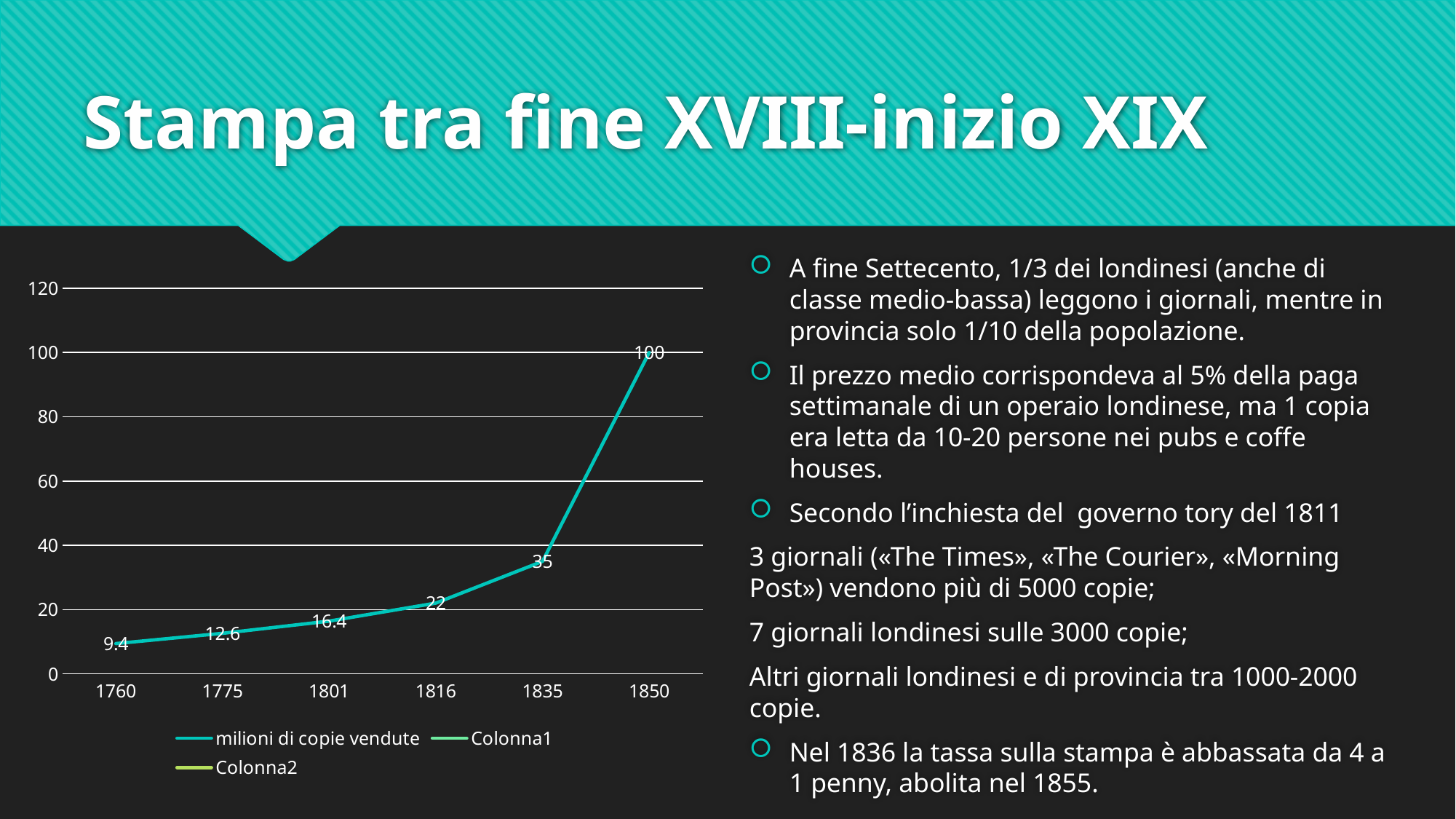
What is the value for 1801 in the chart? 16.4 Which is larger, the value for 1816 or the value for 1801? 1816 How many entries does the chart legend list? 3 Which year has the highest value in the chart? 1850 What is the value for 1850 in the chart? 100 What is the value for 1760 in the chart? 9.4 What is the difference between the values for 1850 and 1835? 65 What kind of chart is shown on the slide? line chart How many years are plotted on the x axis of the chart? 6 Which year has the lowest value in the chart? 1760 What is the difference between the values for 1775 and 1760? 3.2 What is the value for 1835 in the chart? 35